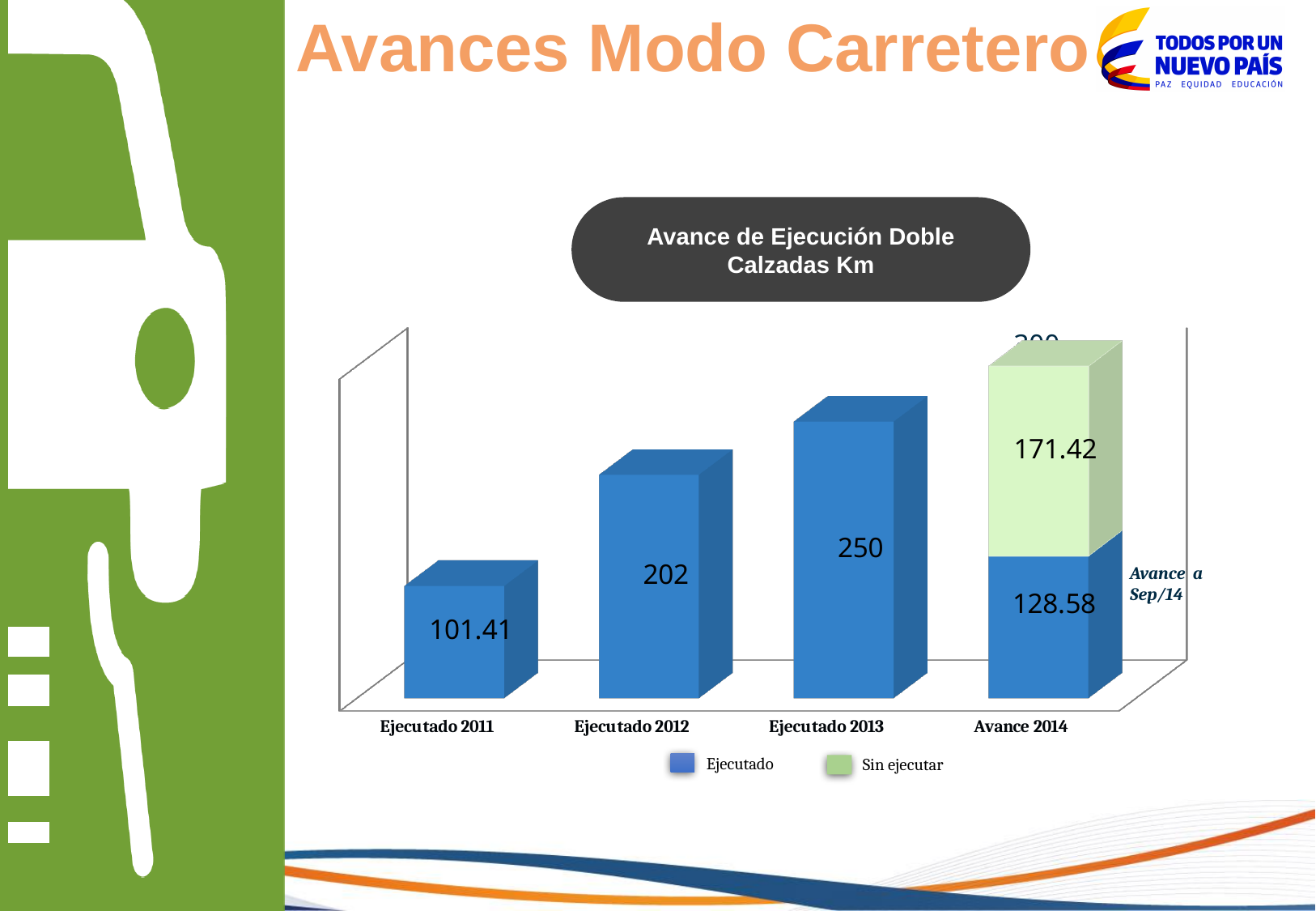
What is the value for Ejecutado 2011? 101.41 How many series does the legend list? 2 What kind of chart is shown on the slide? Bar chart What is the value for Ejecutado 2012? 202 Which category has the lowest Ejecutado value? Ejecutado 2011 Which is larger, the Ejecutado value for 2012 or the Ejecutado value for Avance 2014? Ejecutado 2012 What is the total of the stacked bar for Avance 2014? 300 What is the value for Ejecutado 2013? 250 What is the Sin ejecutar value for Avance 2014? 171.42 Which category has the highest Ejecutado value? Ejecutado 2013 What is the difference between the Ejecutado values for 2013 and 2012? 48 What is the Ejecutado value for Avance 2014? 128.58